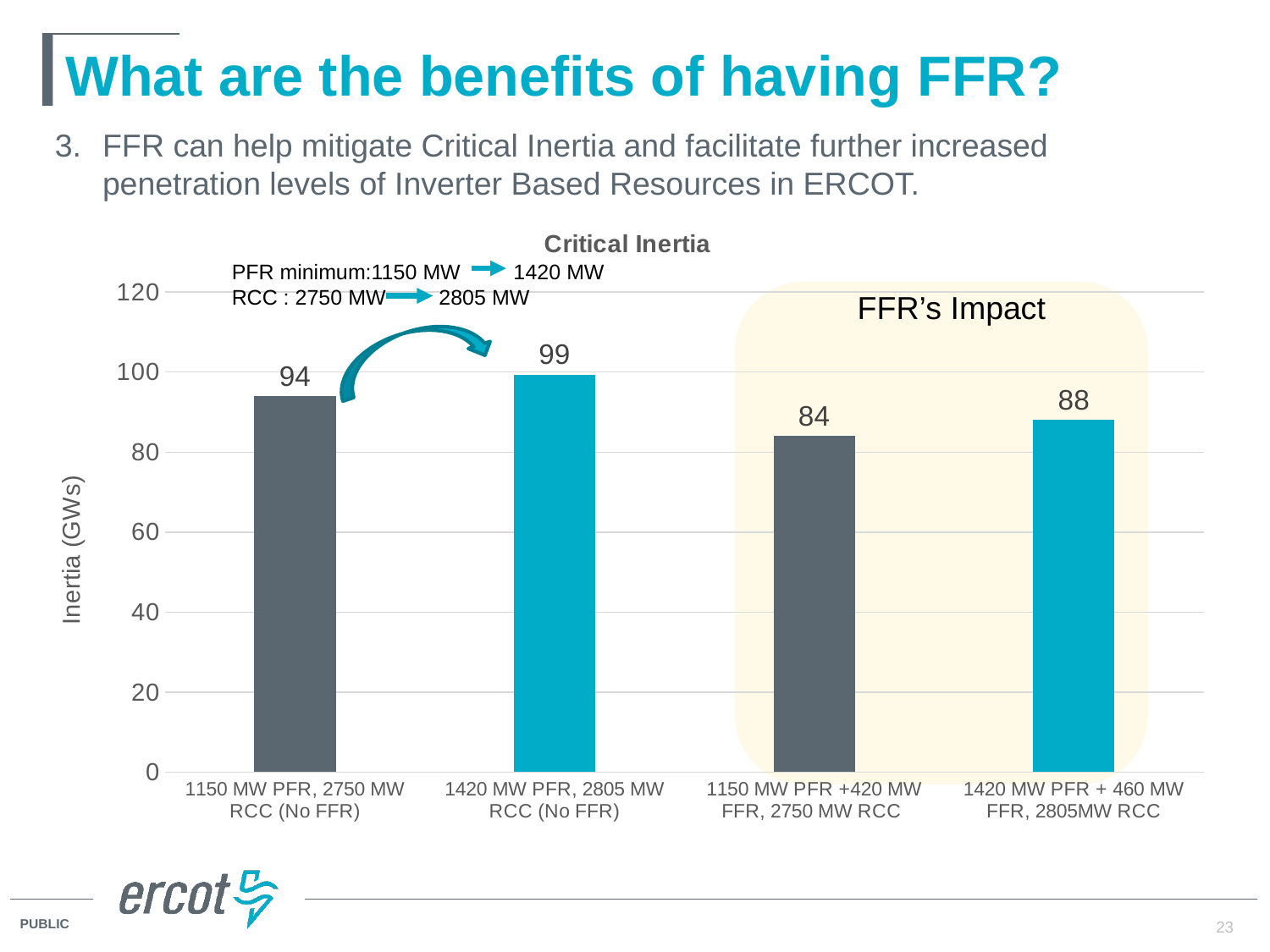
What is the Critical Inertia value for the '1420 MW PFR, 2805 MW RCC (No FFR)' category? 99 What is the Critical Inertia value for the '1150 MW PFR, 2750 MW RCC (No FFR)' category? 94 What is the Critical Inertia value for the '1150 MW PFR +420 MW FFR, 2750 MW RCC' category? 84 Which category has the lowest Critical Inertia value? 1150 MW PFR +420 MW FFR, 2750 MW RCC What is the difference between the Critical Inertia values for '1420 MW PFR, 2805 MW RCC (No FFR)' and '1150 MW PFR, 2750 MW RCC (No FFR)'? 5 Which is larger: the Critical Inertia value for '1150 MW PFR, 2750 MW RCC (No FFR)' or for '1420 MW PFR + 460 MW FFR, 2805MW RCC'? 1150 MW PFR, 2750 MW RCC (No FFR) What kind of chart is used to show Critical Inertia? Bar chart What is the Critical Inertia value for the '1420 MW PFR + 460 MW FFR, 2805MW RCC' category? 88 What is the label of the vertical axis in the Critical Inertia chart? Inertia (GWs) How many categories are shown in the Critical Inertia chart? 4 Which category has the highest Critical Inertia value? 1420 MW PFR, 2805 MW RCC (No FFR) What is the difference between the Critical Inertia values for '1420 MW PFR + 460 MW FFR, 2805MW RCC' and '1150 MW PFR +420 MW FFR, 2750 MW RCC'? 4